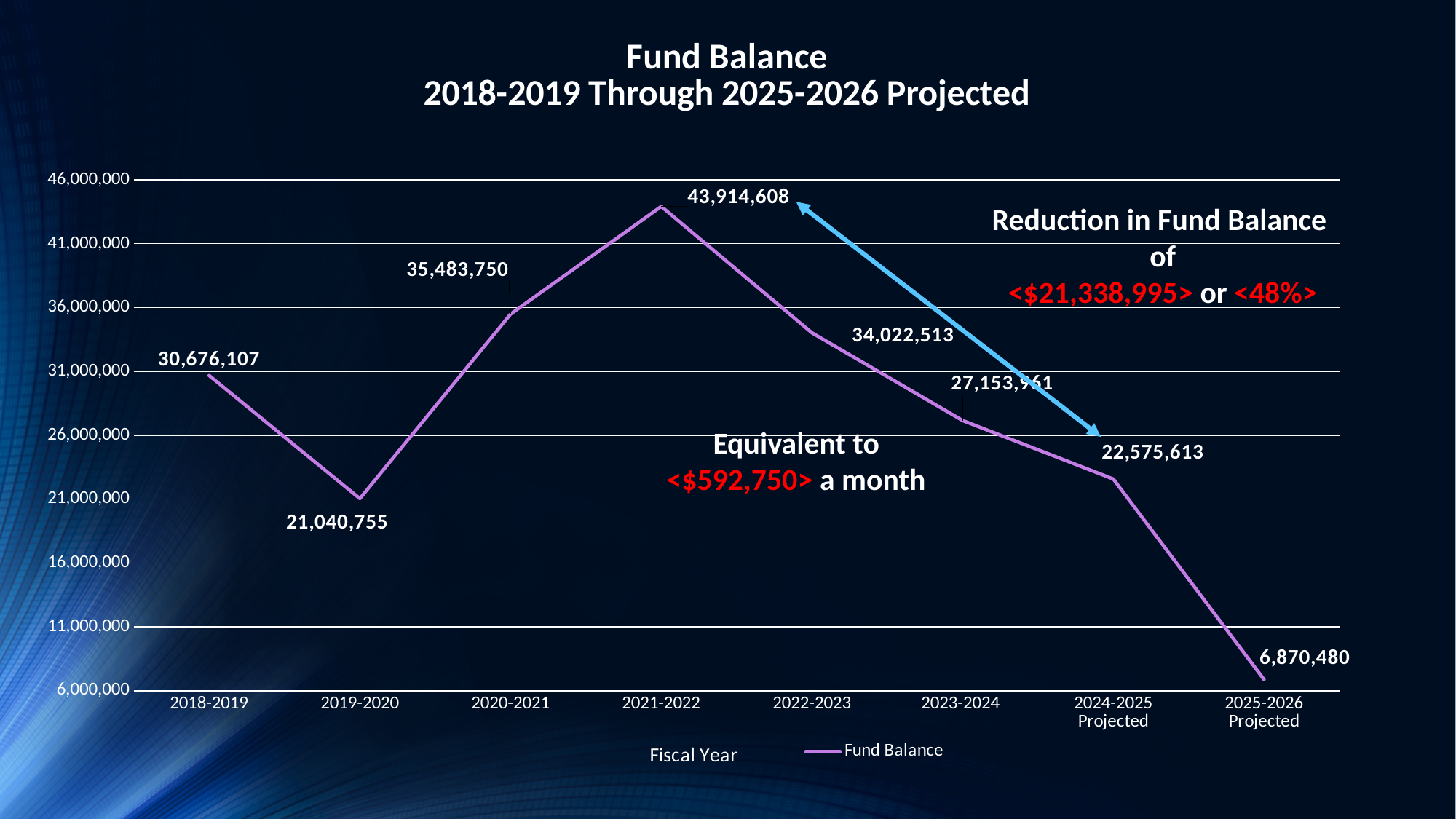
Which is larger, the fund balance for 2020-2021 or for 2022-2023? 2020-2021 Which fiscal year has the lowest fund balance? 2025-2026 Projected How many series does the legend list? 1 What kind of chart is shown on the slide? Line chart What is the fund balance for 2022-2023? 34,022,513 How many fiscal years are plotted on the chart? 8 Which fiscal year has the highest fund balance? 2021-2022 What is the difference between the fund balance in 2021-2022 and the projected fund balance in 2024-2025? 21,338,995 What is the fund balance for 2019-2020? 21,040,755 What is the fund balance for 2021-2022? 43,914,608 What is the difference between the fund balance in 2018-2019 and in 2019-2020? 9,635,352 What is the projected fund balance for 2025-2026? 6,870,480